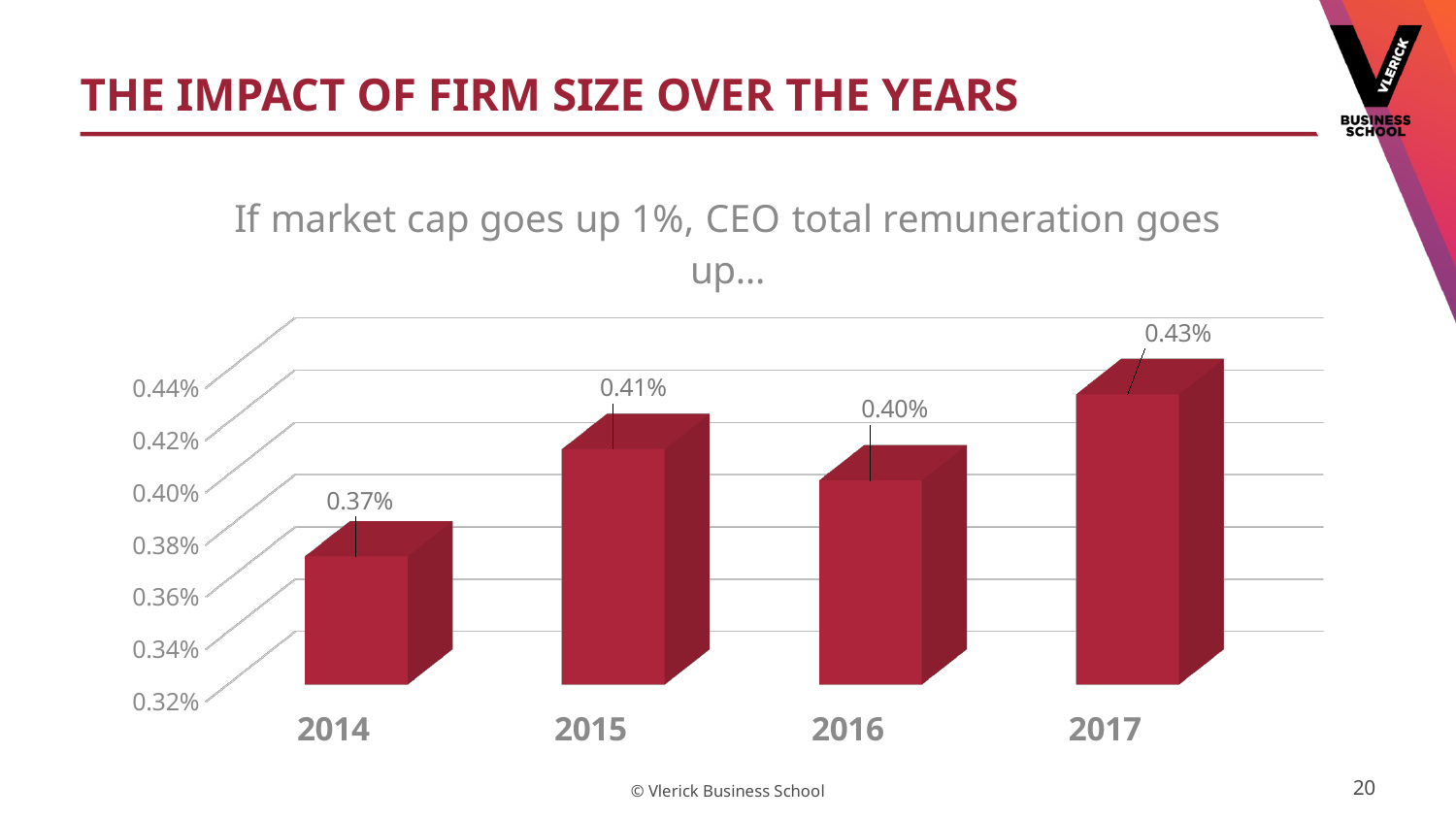
What kind of chart is shown on the slide? bar chart What is the title of the chart? If market cap goes up 1%, CEO total remuneration goes up… Which is larger, the value for 2015 or the value for 2016? 2015 What is the value for 2014? 0.37% What is the value for 2015? 0.41% What is the value for 2016? 0.40% Which year has the lowest value? 2014 How many years are shown on the chart? 4 Which year has the highest value? 2017 What is the difference between the values for 2017 and 2014? 0.06% Is the value for 2017 greater or less than 0.42%? greater What is the value for 2017? 0.43%